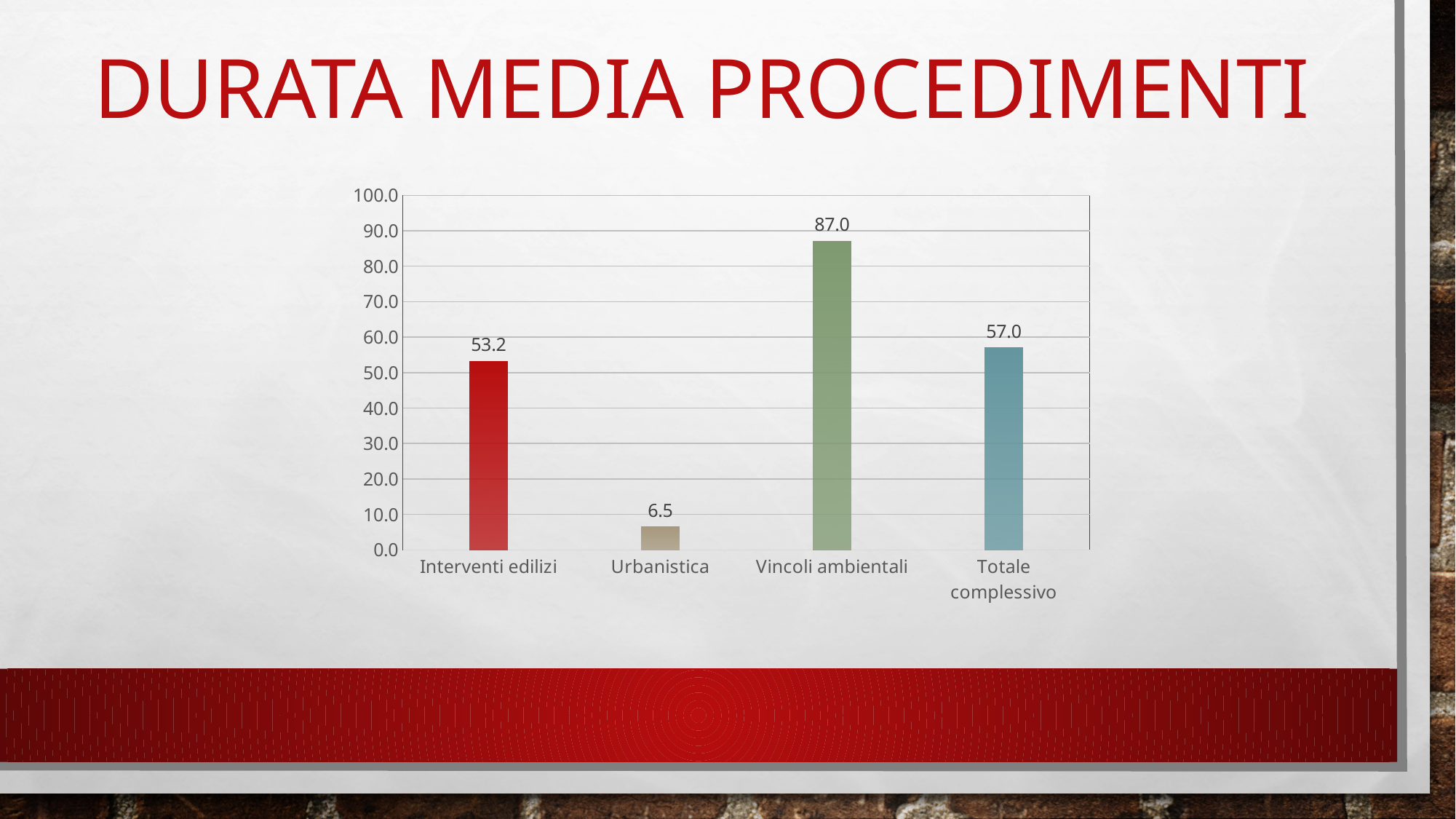
Which is larger, the value for Totale complessivo or the value for Interventi edilizi? Totale complessivo What is the value for Interventi edilizi? 53.2 What is the value for Vincoli ambientali? 87.0 What is the value for Urbanistica? 6.5 What is the difference between the values for Vincoli ambientali and Interventi edilizi? 33.8 What is the value for Totale complessivo? 57.0 Is the value for Vincoli ambientali greater or less than 80.0? greater What kind of chart is shown on the slide? Bar chart How many categories are shown on the x axis? 4 Which category has the lowest value? Urbanistica Which category has the highest value? Vincoli ambientali What is the difference between the values for Totale complessivo and Urbanistica? 50.5